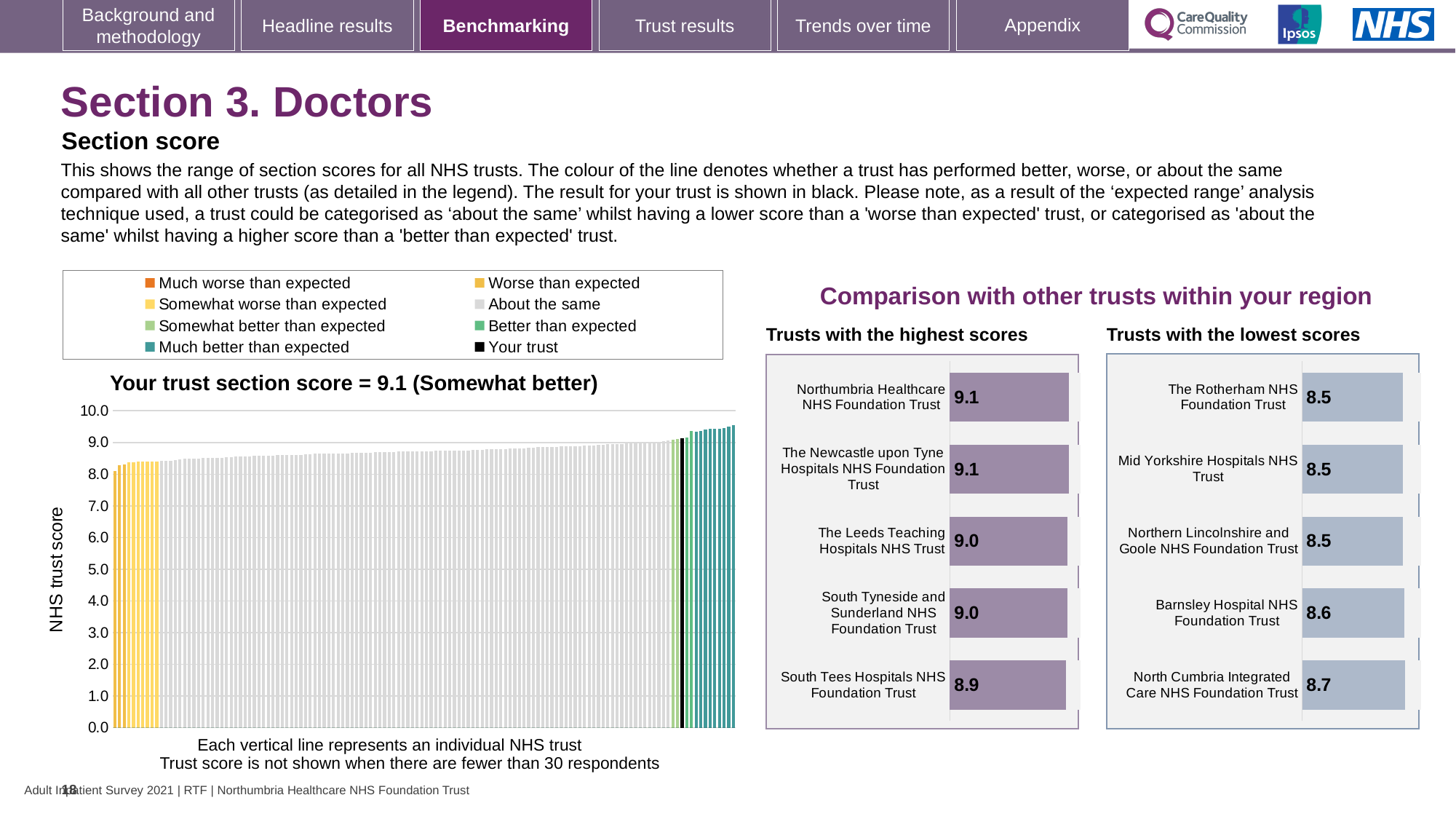
In the 'Your trust section score' chart on the left, do the bar values rise or fall from left to right? Rise In the 'Trusts with the highest scores' chart, what is the difference between the scores of Northumbria Healthcare NHS Foundation Trust and South Tees Hospitals NHS Foundation Trust? 0.2 What type of chart is the 'Your trust section score' chart on the left? Bar chart In the 'Trusts with the highest scores' chart, what is the score for South Tees Hospitals NHS Foundation Trust? 8.9 In the 'Trusts with the lowest scores' chart, which trust has the highest score? North Cumbria Integrated Care NHS Foundation Trust In the 'Trusts with the highest scores' chart, which trust has the lowest score? South Tees Hospitals NHS Foundation Trust How many trusts are listed in the 'Trusts with the lowest scores' chart? 5 According to the title of the chart on the left, what is your trust's section score? 9.1 (Somewhat better) In the 'Trusts with the lowest scores' chart, which has the larger score: North Cumbria Integrated Care NHS Foundation Trust or The Rotherham NHS Foundation Trust? North Cumbria Integrated Care NHS Foundation Trust In the 'Trusts with the highest scores' chart, what is the score for The Leeds Teaching Hospitals NHS Trust? 9.0 In the 'Trusts with the lowest scores' chart, what is the score for Barnsley Hospital NHS Foundation Trust? 8.6 In the 'Your trust section score' chart on the left, is the value of the rightmost bar greater or less than 9.0? greater